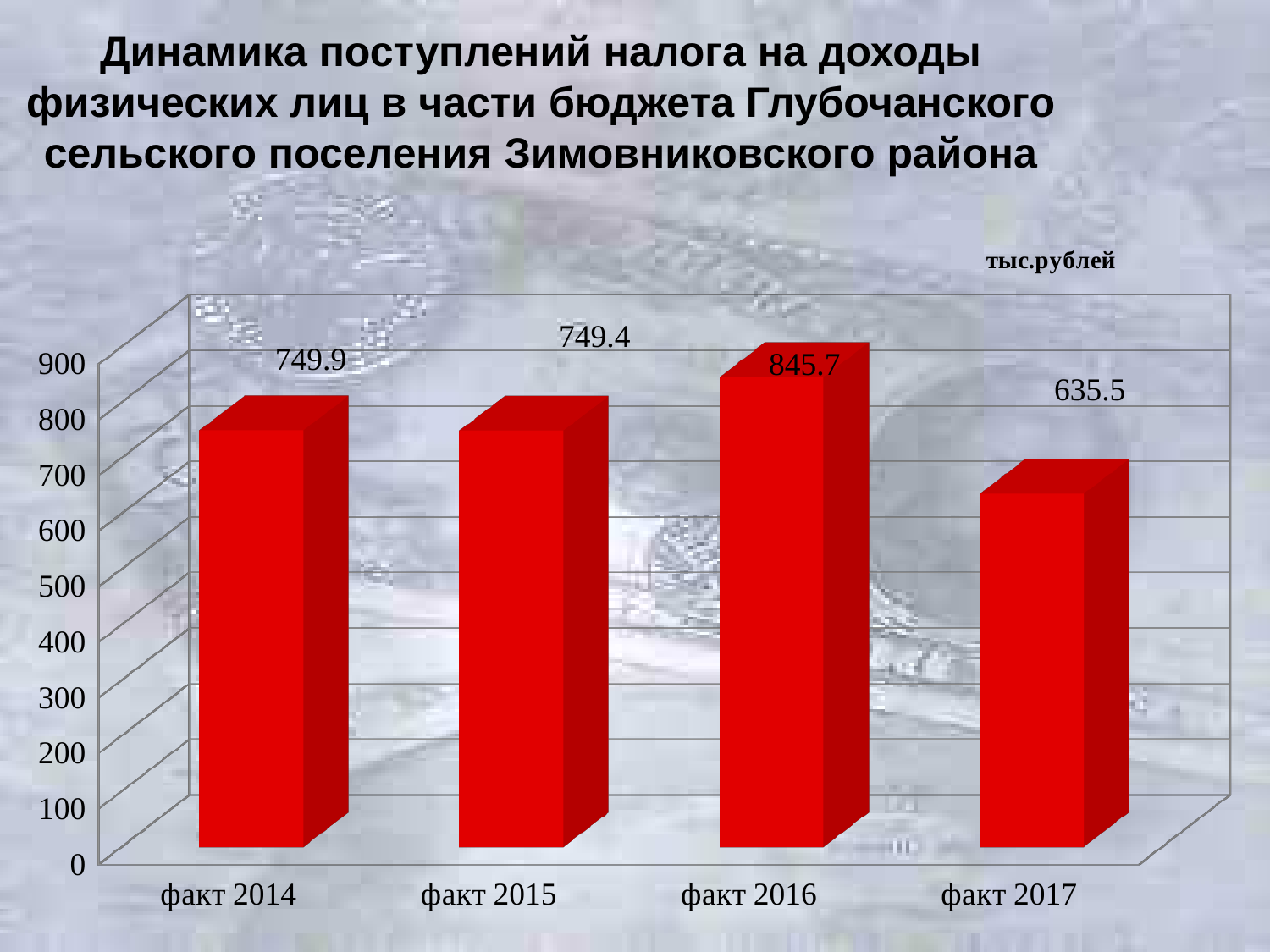
What is the value for факт 2017? 635.5 What is the value for факт 2015? 749.4 What is the difference between the values for факт 2016 and факт 2017? 210.2 Which category has the highest value? факт 2016 What is the value for факт 2016? 845.7 What is the value for факт 2014? 749.9 Which category has the lowest value? факт 2017 Which is larger, the value for факт 2016 or the value for факт 2015? факт 2016 What is the difference between the values for факт 2014 and факт 2017? 114.4 How many categories are shown on the x axis? 4 What kind of chart is shown on the slide? bar chart Is the value for факт 2017 greater or less than 700? less